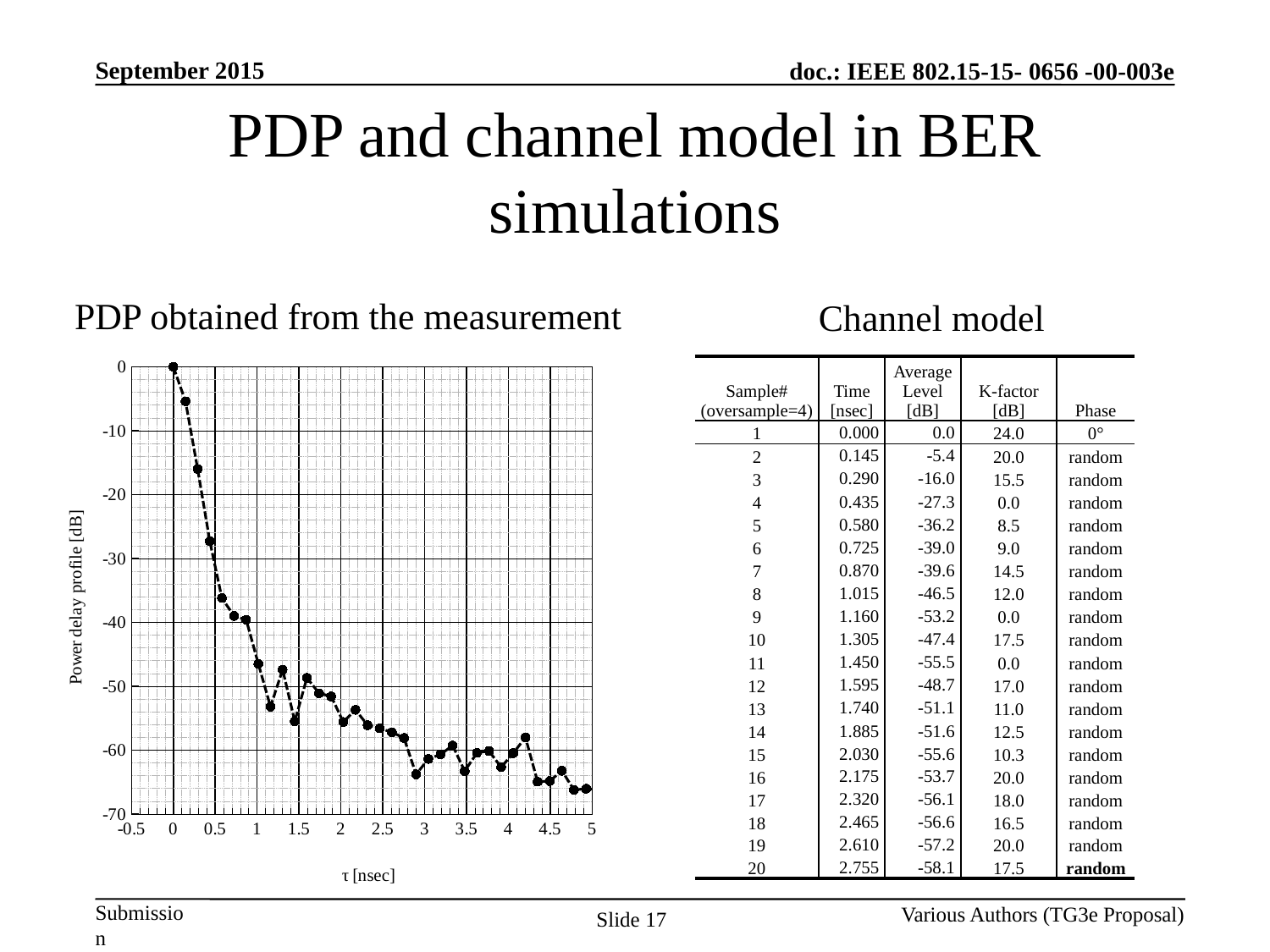
In the PDP chart, do the values generally rise or fall as τ increases? fall In the PDP chart, what is the power delay profile value at τ = 0 nsec? 0 What is the x-axis label of the PDP chart? τ [nsec] In the PDP chart, is the value at τ = 5 nsec greater or less than -60? less What kind of chart is shown under 'PDP obtained from the measurement'? line chart In the PDP chart, is the value at τ = 2 nsec greater or less than -50? less In the PDP chart, is the value at τ = 1 nsec greater or less than -40? less What is the y-axis label of the PDP chart? Power delay profile [dB] In the PDP chart, at which τ value is the power delay profile highest? 0 In the PDP chart, which has the larger value: the point at τ = 0 nsec or the point at τ = 5 nsec? τ = 0 nsec